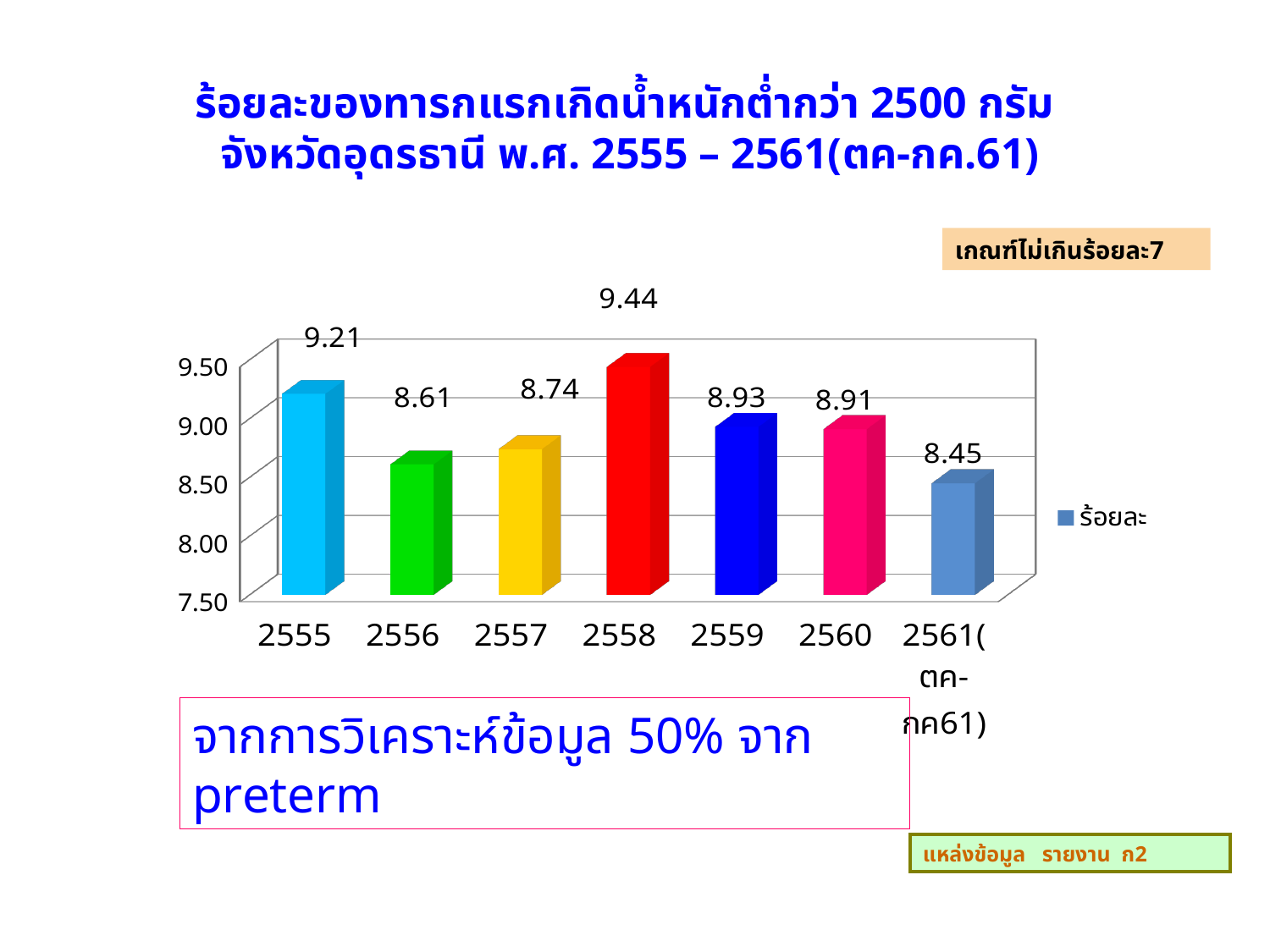
How many series does the legend list? 1 What is the difference between the values for 2558 and 2561(ตค-กค61)? 0.99 What is the value for 2558? 9.44 What is the difference between the values for 2555 and 2556? 0.60 Which year has the highest value? 2558 What kind of chart is shown on the slide? bar chart Is the value for 2556 greater or less than 9.00? less What is the value for 2561(ตค-กค61)? 8.45 What is the value for 2556? 8.61 Which is larger, the value for 2555 or the value for 2557? 2555 Which category has the lowest value? 2561(ตค-กค61) How many categories are shown on the x axis? 7